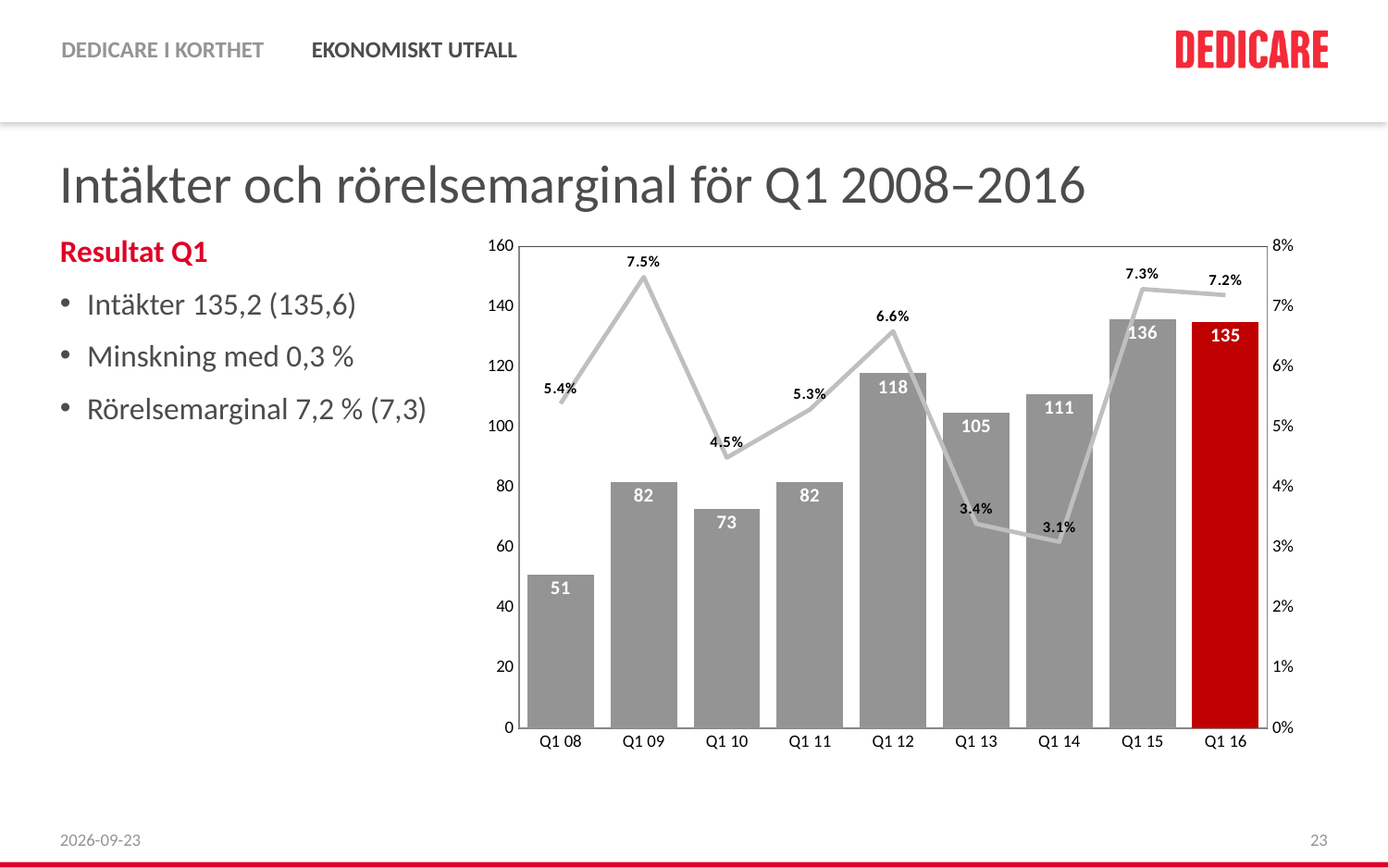
What is the revenue bar value for Q1 12? 118 What operating margin percentage is shown for Q1 09? 7.5% What is the difference between the bar values for Q1 15 and Q1 08? 85 How many quarters are shown on the x axis? 9 What is the bar value for Q1 16? 135 Which bar is coloured red instead of grey? Q1 16 Do the bar values rise or fall from Q1 12 to Q1 13? Fall Which quarter has the lowest bar value? Q1 08 Which is larger, the bar value for Q1 13 or Q1 14? Q1 14 Which quarter has the lowest operating margin on the line? Q1 14 Which quarter has the highest bar value? Q1 15 What kind of chart is shown on the slide? Bar chart with a line